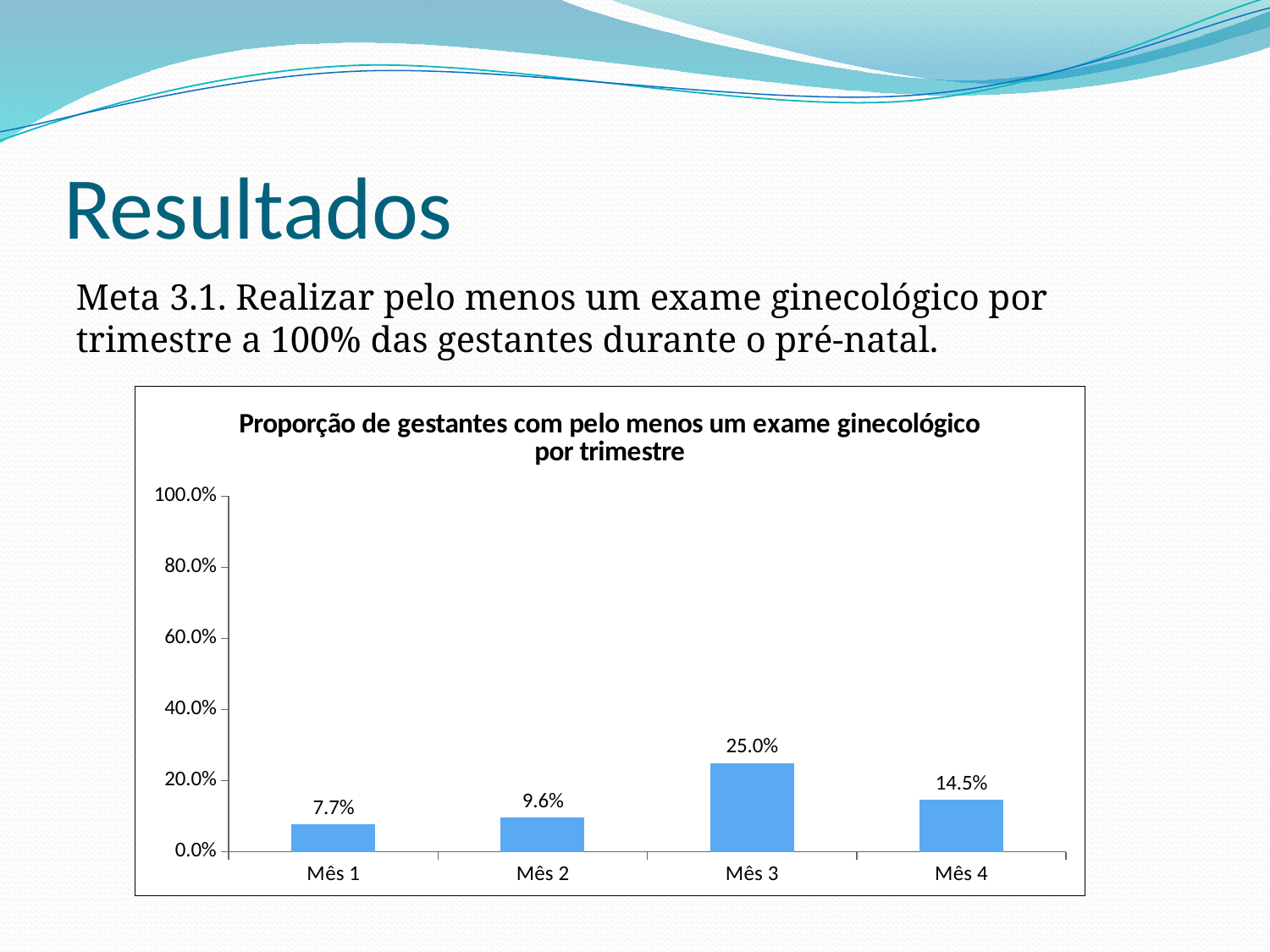
What is the value for Mês 4? 14.5% What is the value for Mês 3? 25.0% What is the difference between the values for Mês 3 and Mês 2? 15.4% Which is larger, the value for Mês 2 or the value for Mês 4? Mês 4 What is the difference between the values for Mês 4 and Mês 1? 6.8% What is the title of the chart? Proporção de gestantes com pelo menos um exame ginecológico por trimestre Which month has the lowest value? Mês 1 What is the value for Mês 1? 7.7% How many months are shown on the x axis? 4 What kind of chart is shown on the slide? bar chart Which month has the highest value? Mês 3 Is the value for Mês 3 greater or less than 20.0%? greater